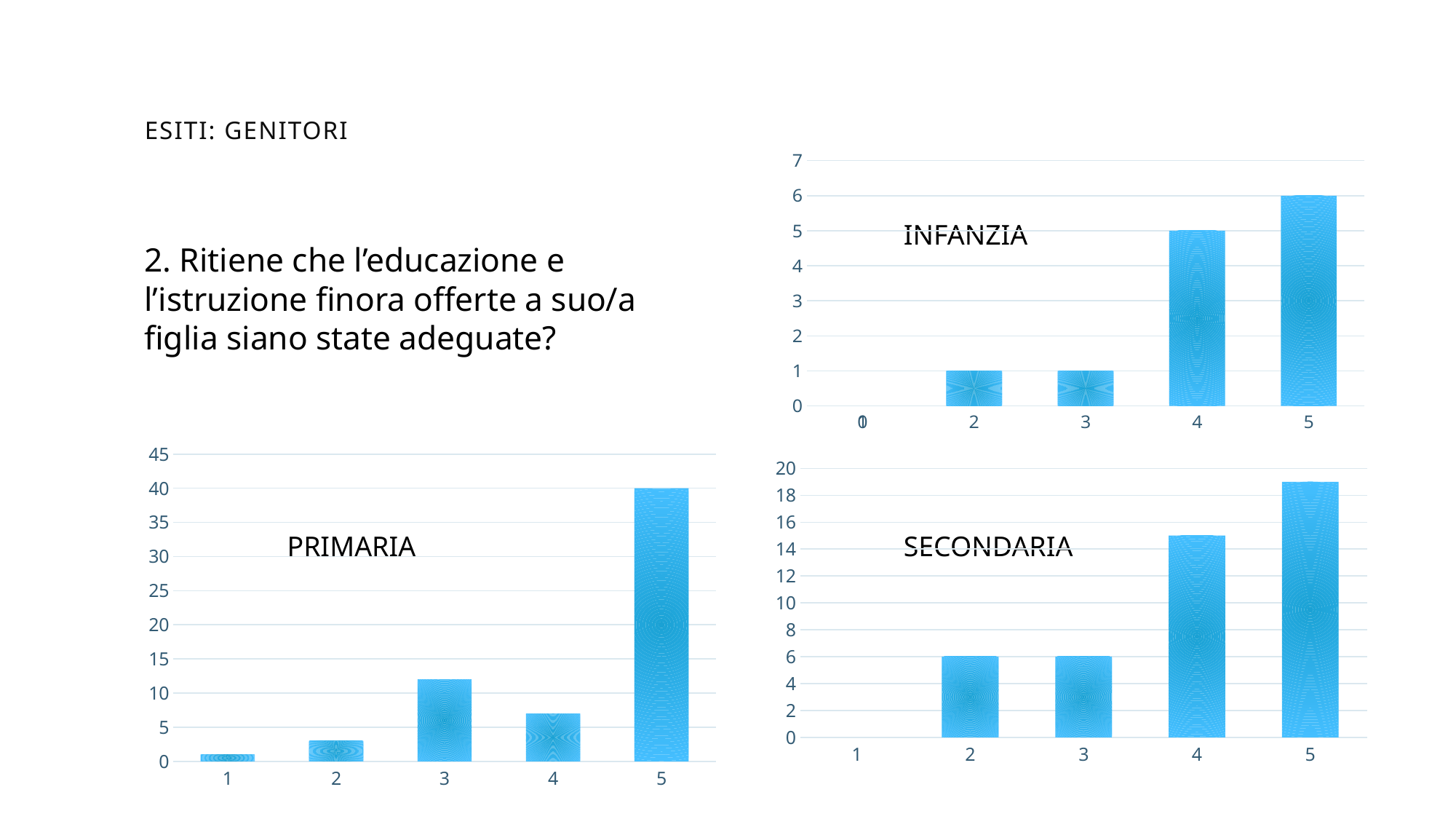
In the PRIMARIA chart, is the value for category 3 greater or less than 10? greater In the PRIMARIA chart, which category has the highest value? 5 In the PRIMARIA chart, is the value for category 4 greater or less than 10? less In the PRIMARIA chart, what is the value for category 5? 40 In the SECONDARIA chart, is the value for category 5 greater or less than 18? greater In the INFANZIA chart, what is the value for category 4? 5 In the SECONDARIA chart, what is the value for category 2? 6 In the INFANZIA chart, what is the difference between the values for category 5 and category 4? 1 What kind of chart is the PRIMARIA chart? bar chart In the SECONDARIA chart, which is larger, the value for category 4 or category 5? 5 In the INFANZIA chart, which category has the highest value? 5 In the INFANZIA chart, what is the value for category 5? 6